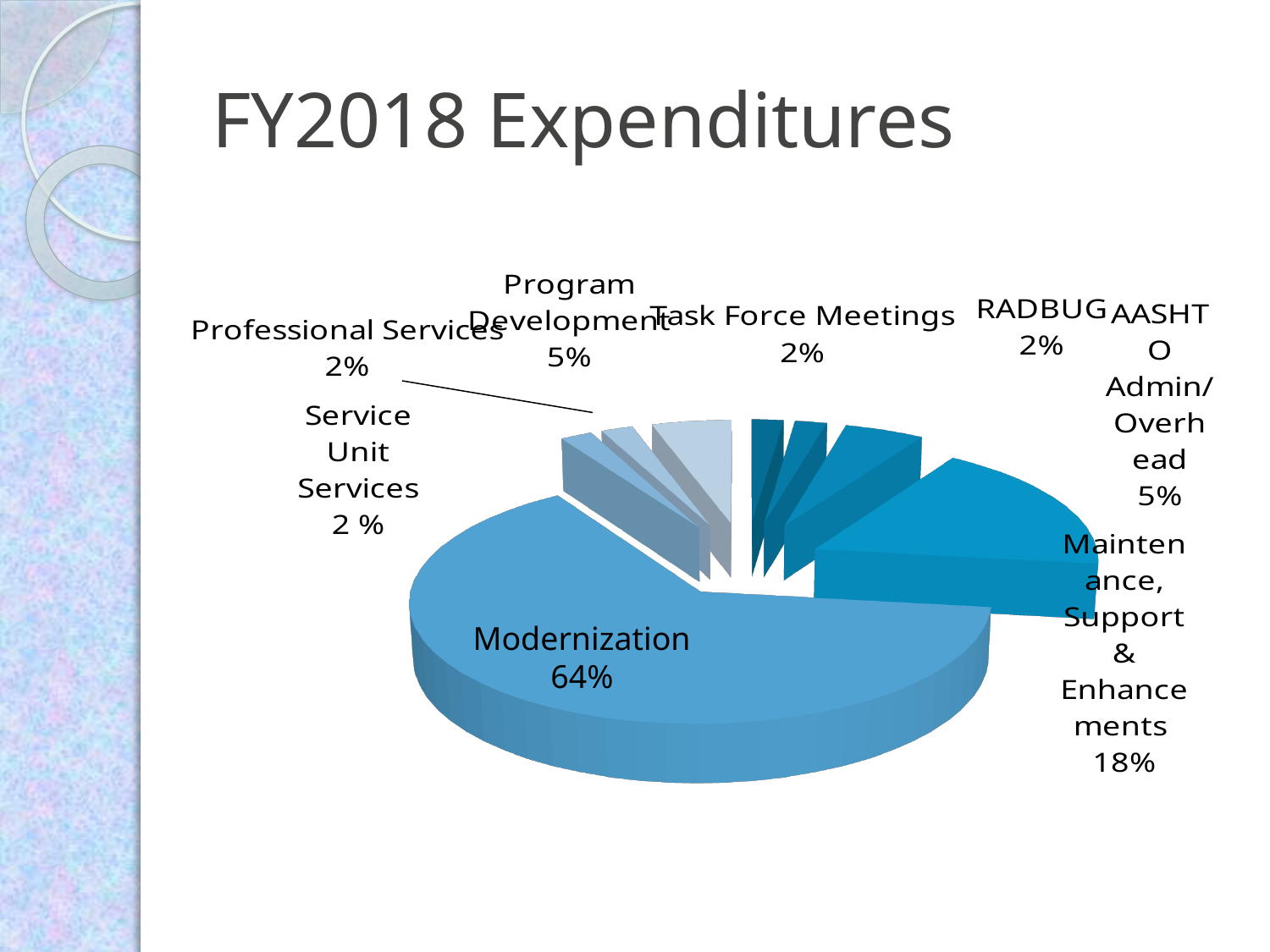
What is the title of the slide? FY2018 Expenditures What share is shown for Task Force Meetings? 2% What is the value for RADBUG? 2% How many slices does the pie chart have? 8 Which category has the largest slice of the pie? Modernization What share of FY2018 expenditures is Modernization? 64% What percentage of the pie is Maintenance, Support & Enhancements? 18% Which is larger, Program Development or Professional Services? Program Development What is the value shown for AASHTO Admin/Overhead? 5% What is the difference in percentage points between Modernization and Maintenance, Support & Enhancements? 46 What percentage is labelled for Program Development? 5% What kind of chart is shown on the slide? Pie chart